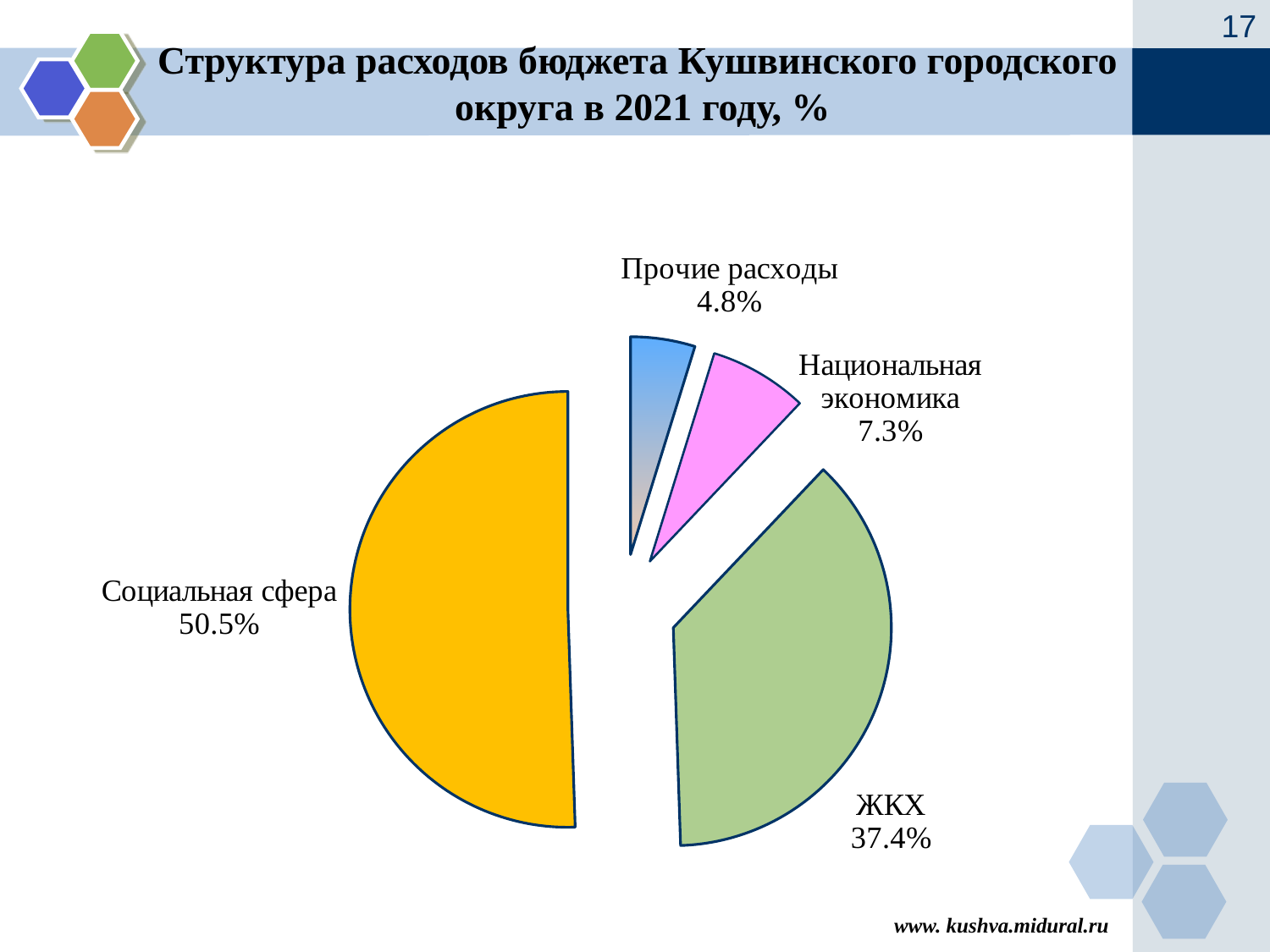
Which is larger, Национальная экономика or Прочие расходы? Национальная экономика What share of budget expenditure does Социальная сфера account for? 50.5% What is the title of the chart on the slide? Структура расходов бюджета Кушвинского городского округа в 2021 году, % What is the difference in percentage points between Социальная сфера and ЖКХ? 13.1 What is the value shown for ЖКХ? 37.4% Which category has the largest share of the pie? Социальная сфера What is the value shown for Прочие расходы? 4.8% Which category has the smallest share of the pie? Прочие расходы What kind of chart is shown on the slide? pie chart How many slices does the pie chart have? 4 What is the value shown for Национальная экономика? 7.3% What is the difference in percentage points between Национальная экономика and Прочие расходы? 2.5